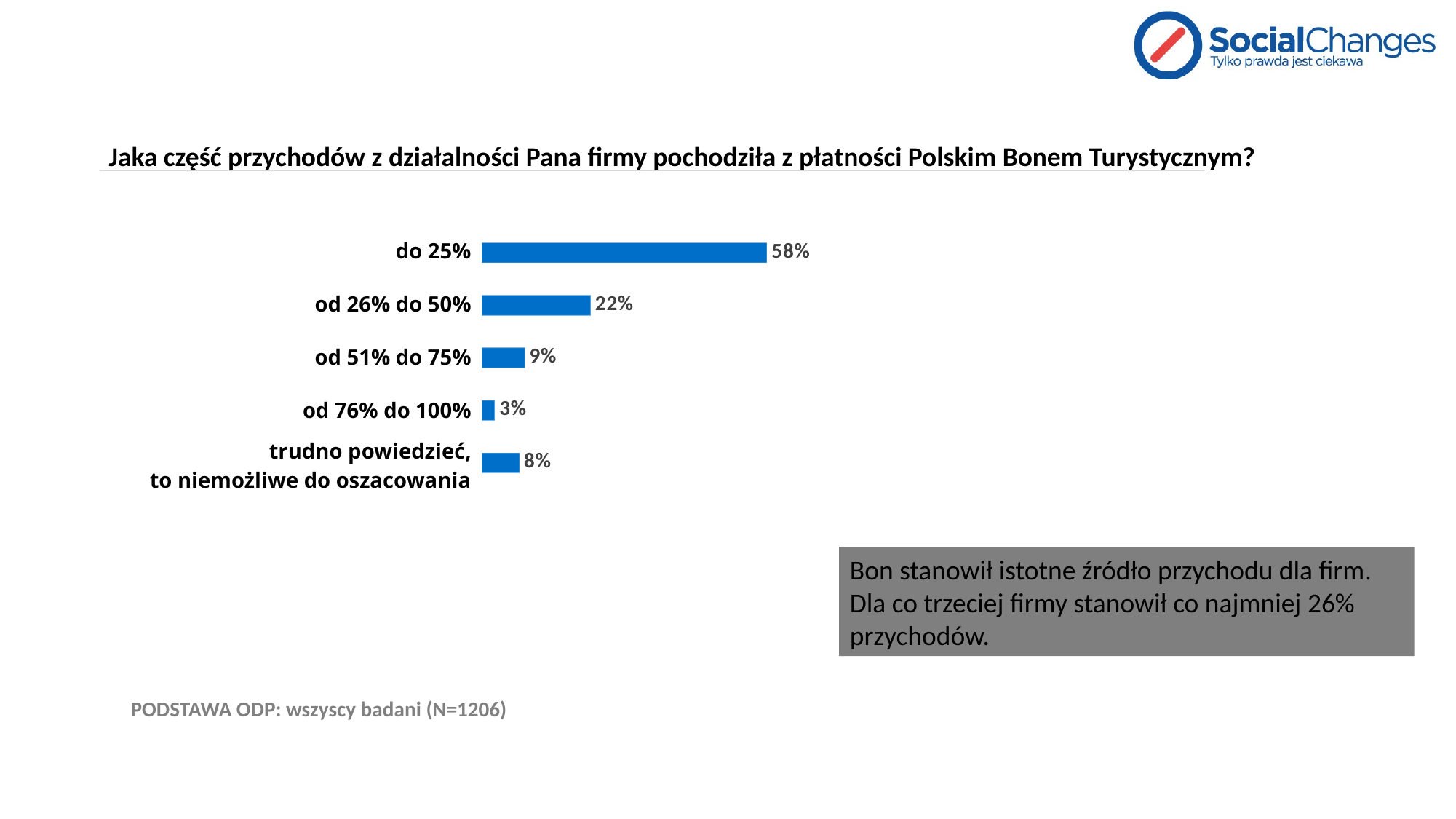
How many categories are shown in the chart? 5 Which category has the lowest value? od 76% do 100% What is the value for the category "od 76% do 100%"? 3% What is the difference between the values for "do 25%" and "od 26% do 50%"? 36% What is the value for the category "trudno powiedzieć, to niemożliwe do oszacowania"? 8% What is the value for the category "od 26% do 50%"? 22% Which is larger: the value for "od 51% do 75%" or the value for "trudno powiedzieć, to niemożliwe do oszacowania"? od 51% do 75% Which category has the highest value? do 25% What is the value for the category "do 25%"? 58% What is the sample size stated at the bottom of the slide? N=1206 What is the value for the category "od 51% do 75%"? 9% What kind of chart is shown on the slide? bar chart